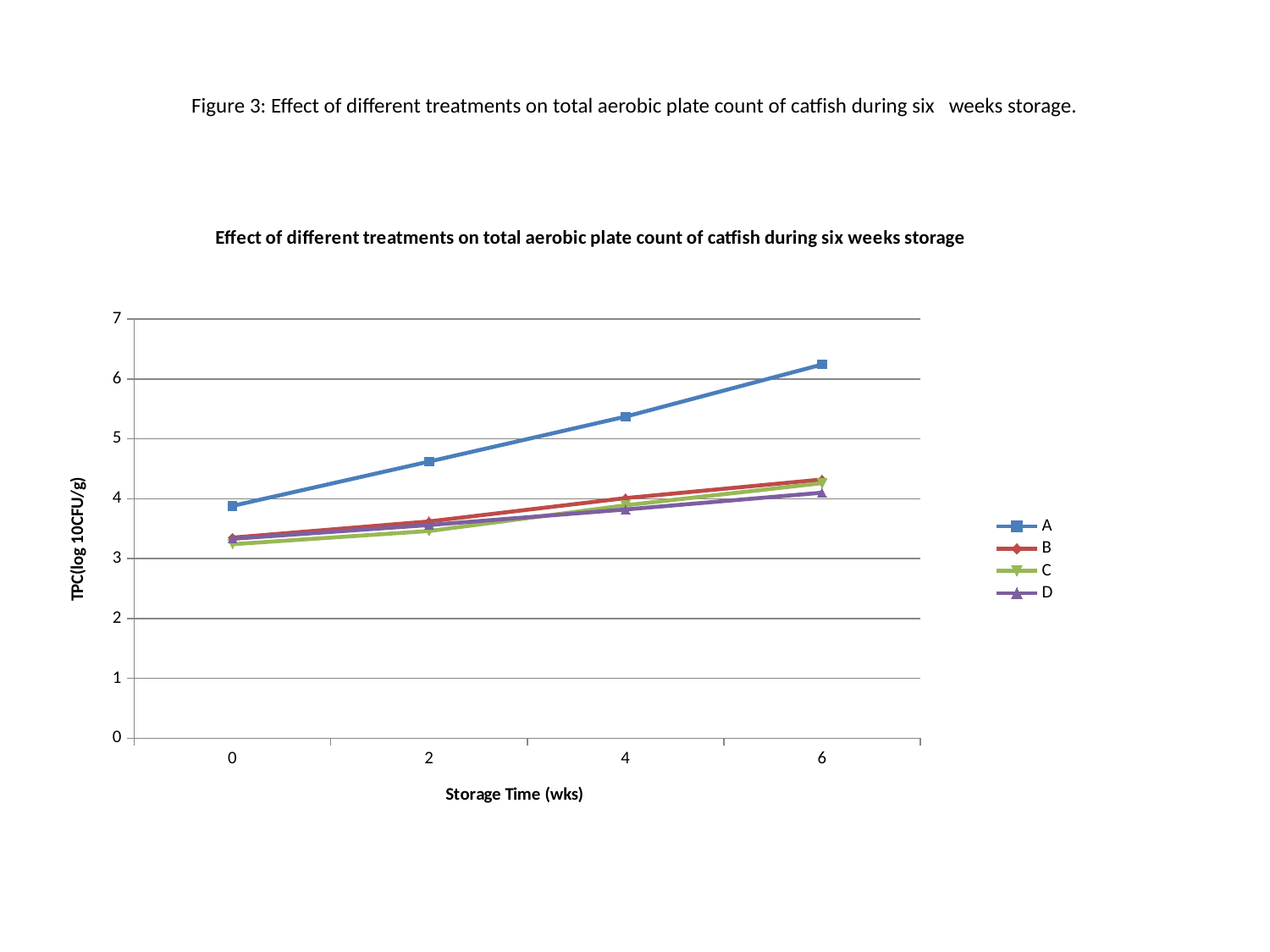
Is the TPC value for treatment C at 0 weeks greater or less than 4? less Which treatment has the highest TPC at 6 weeks of storage? A What kind of chart is shown on the slide? line chart How many series does the legend list? 4 At 6 weeks of storage, which has the larger TPC value, treatment A or treatment D? A What is the label of the y axis? TPC(log 10CFU/g) Is the TPC value for treatment A at 4 weeks greater or less than 5? greater How many storage time points are plotted along the x axis? 4 Is the TPC value for treatment A at 6 weeks greater or less than 6? greater What is the label of the x axis? Storage Time (wks) Does the TPC for treatment A rise or fall as storage time increases? rises